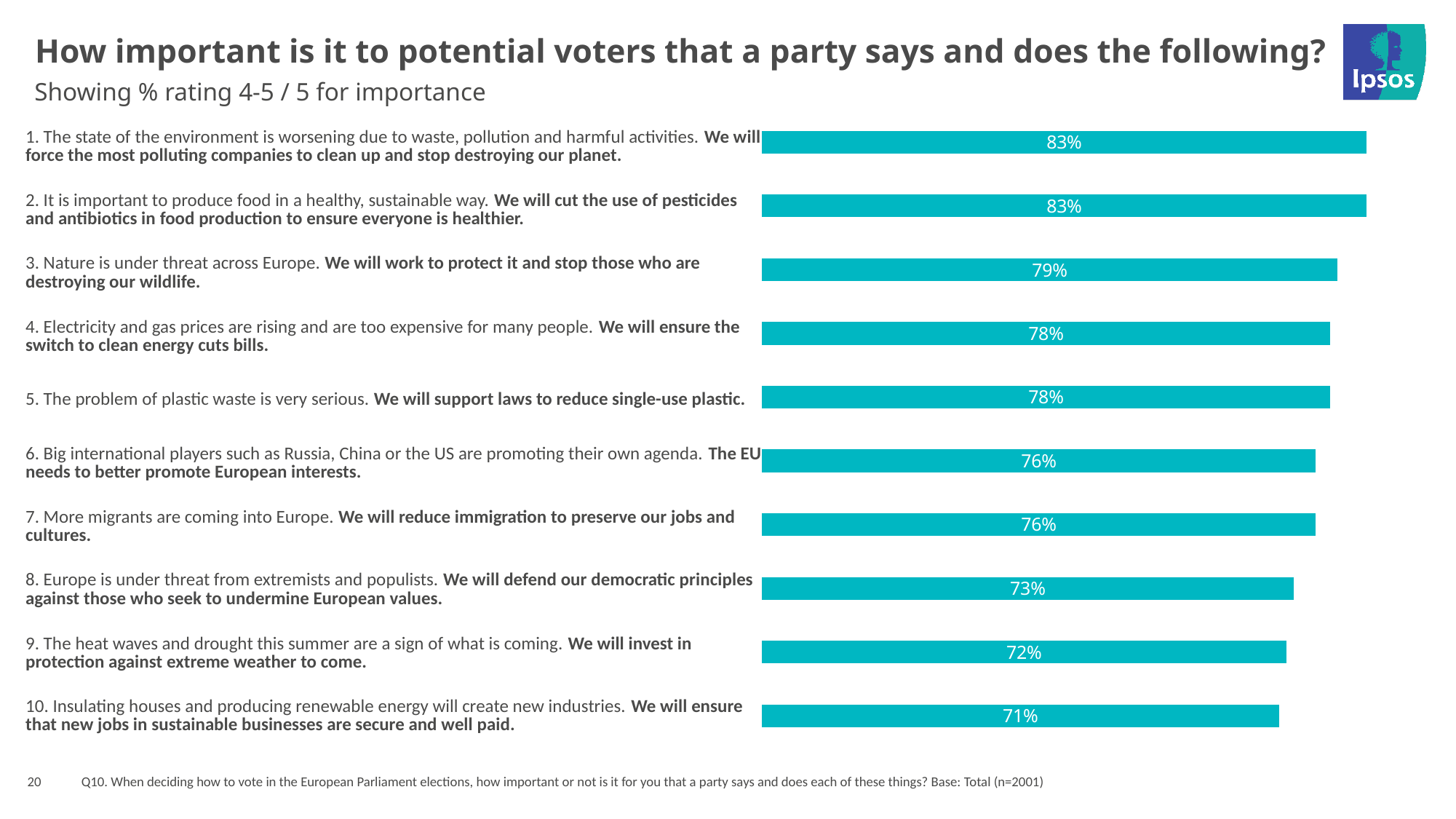
What percentage of potential voters rated item 7, reducing immigration to preserve jobs and cultures, as important (4-5 / 5)? 76% How many items are shown in the chart? 10 What is the difference in percentage points between item 1 (forcing polluting companies to clean up) and item 10 (secure, well-paid jobs in sustainable businesses)? 12 percentage points What is the value shown for item 5, supporting laws to reduce single-use plastic? 78% Which item has the lowest percentage rating it as important? 10. Insulating houses and producing renewable energy will create new industries (71%) What value is shown for item 3, working to protect nature and stop those destroying wildlife? 79% What percentage is shown for item 8, defending democratic principles against those who seek to undermine European values? 73% Do the values decrease or increase going from the top item to the bottom item? Decrease What type of chart is used on this slide? Bar chart Which has a higher value: item 9 (investing in protection against extreme weather) or item 3 (protecting nature and wildlife)? Item 3 (79%) Which has a higher value: item 4 (ensuring the switch to clean energy cuts bills) or item 6 (the EU needs to better promote European interests)? Item 4 (78%) What is the difference between item 2 (cutting pesticides and antibiotics in food production) and item 9 (investing in protection against extreme weather)? 11 percentage points